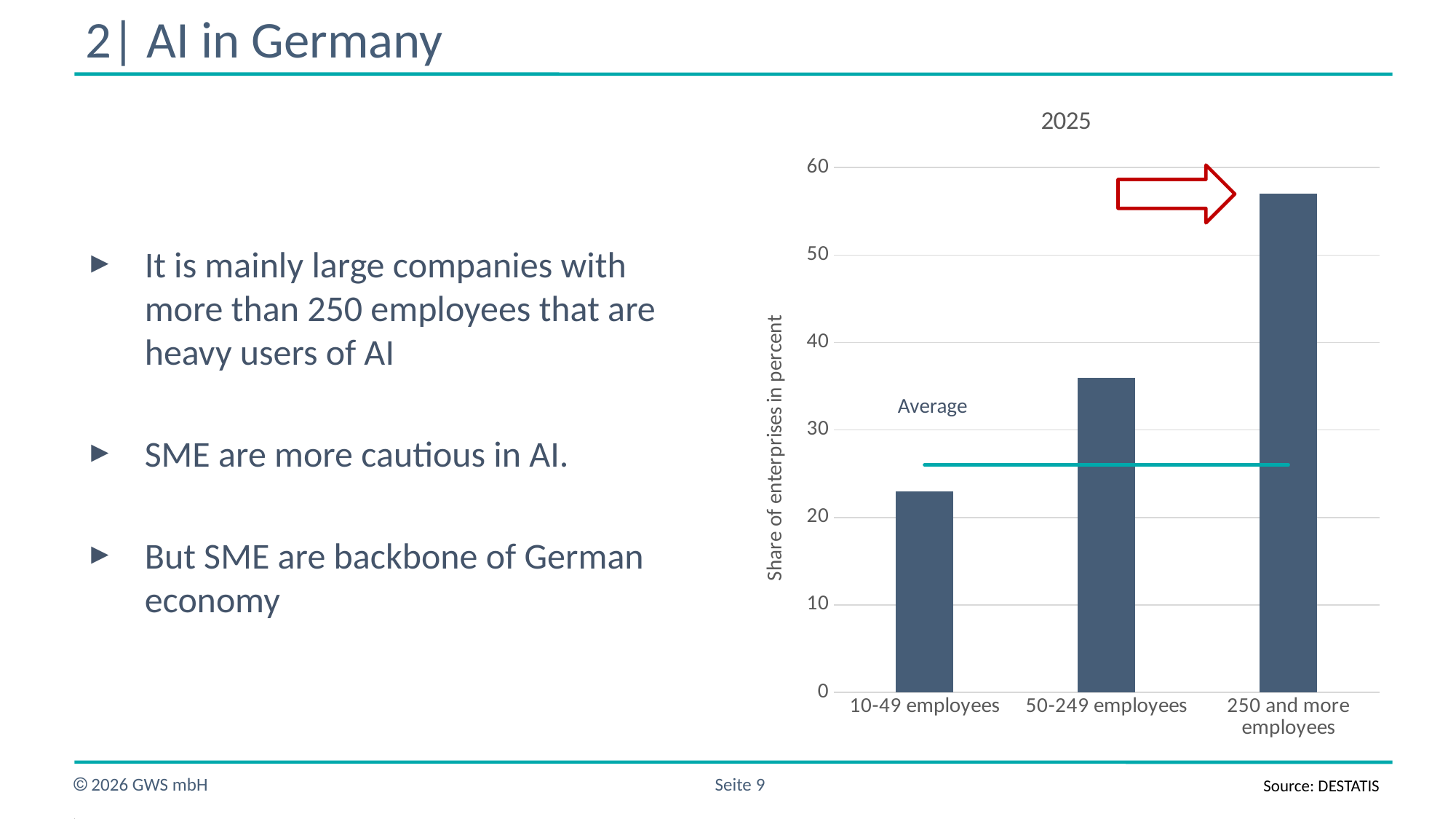
Which category has the highest share of enterprises? 250 and more employees Is the value for 50-249 employees greater or less than 30? greater What kind of chart is shown on the slide? bar chart Which is larger, the value for 50-249 employees or the value for 10-49 employees? 50-249 employees What is the label of the vertical axis of the chart? Share of enterprises in percent How many categories are shown on the x axis of the chart? 3 Which category has the lowest share of enterprises? 10-49 employees Is the value for 250 and more employees greater or less than 50? greater What is the title of the chart? 2025 Is the value for 10-49 employees greater or less than 30? less Do the values rise or fall from left to right along the x axis? rise